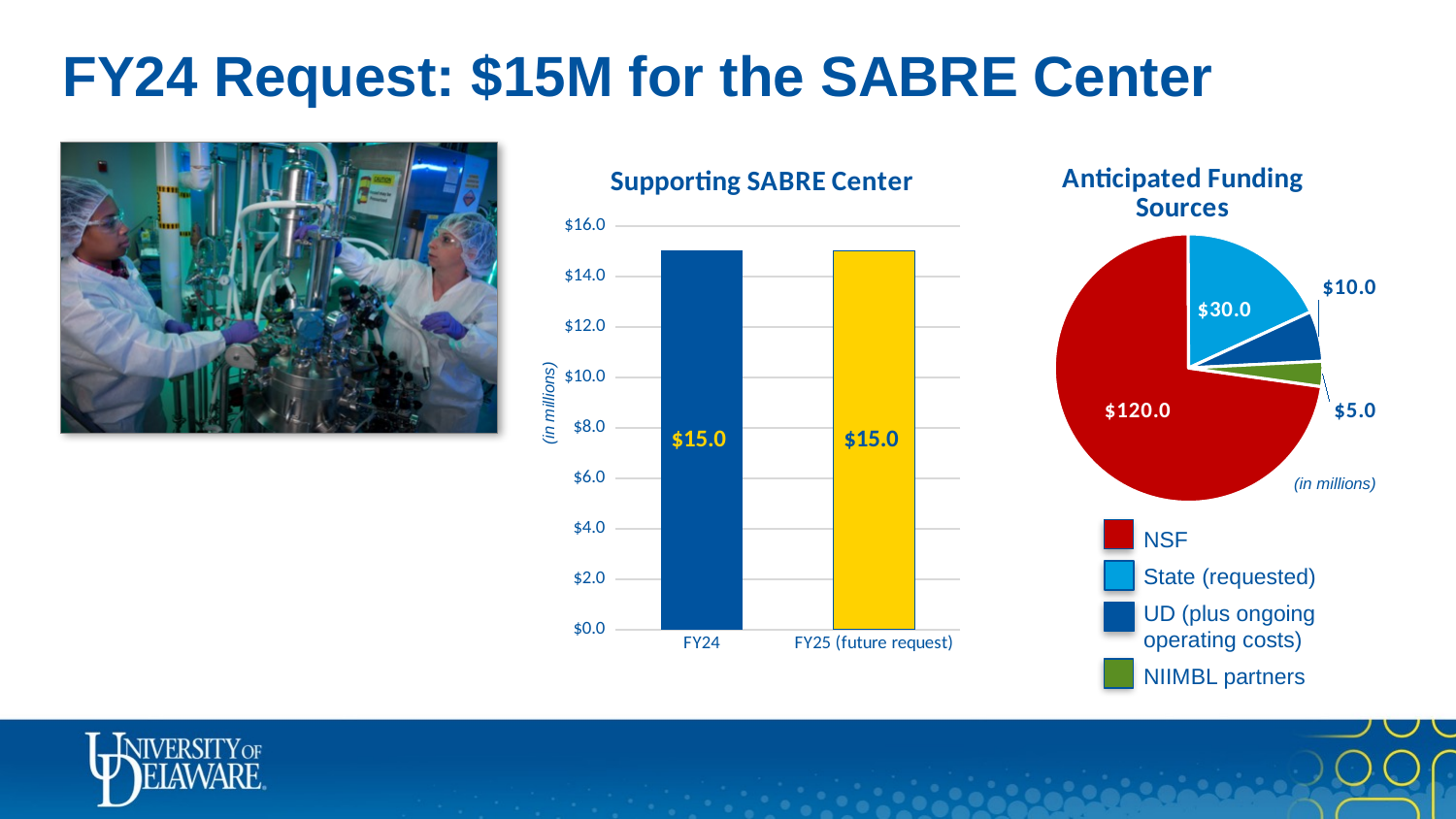
In the 'Supporting SABRE Center' chart, what is the value for FY25 (future request)? $15.0 How many entries does the legend of the 'Anticipated Funding Sources' chart list? 4 In the 'Anticipated Funding Sources' chart, which funding source is the smallest? NIIMBL partners In the 'Supporting SABRE Center' chart, do the values rise, fall or stay the same from FY24 to FY25 (future request)? Stay the same What kind of chart is 'Supporting SABRE Center'? Bar chart In the 'Anticipated Funding Sources' chart, which funding source is the largest? NSF In the 'Anticipated Funding Sources' chart, what is the value for State (requested)? $30.0 In the 'Anticipated Funding Sources' chart, what is the difference between the NSF value and the State (requested) value? $90.0 In the 'Supporting SABRE Center' chart, how many bars are plotted? 2 In the 'Anticipated Funding Sources' chart, what is the value for NSF? $120.0 In the 'Supporting SABRE Center' chart, what is the value for FY24? $15.0 In the 'Supporting SABRE Center' chart, is the value for FY24 greater or less than $10.0? greater